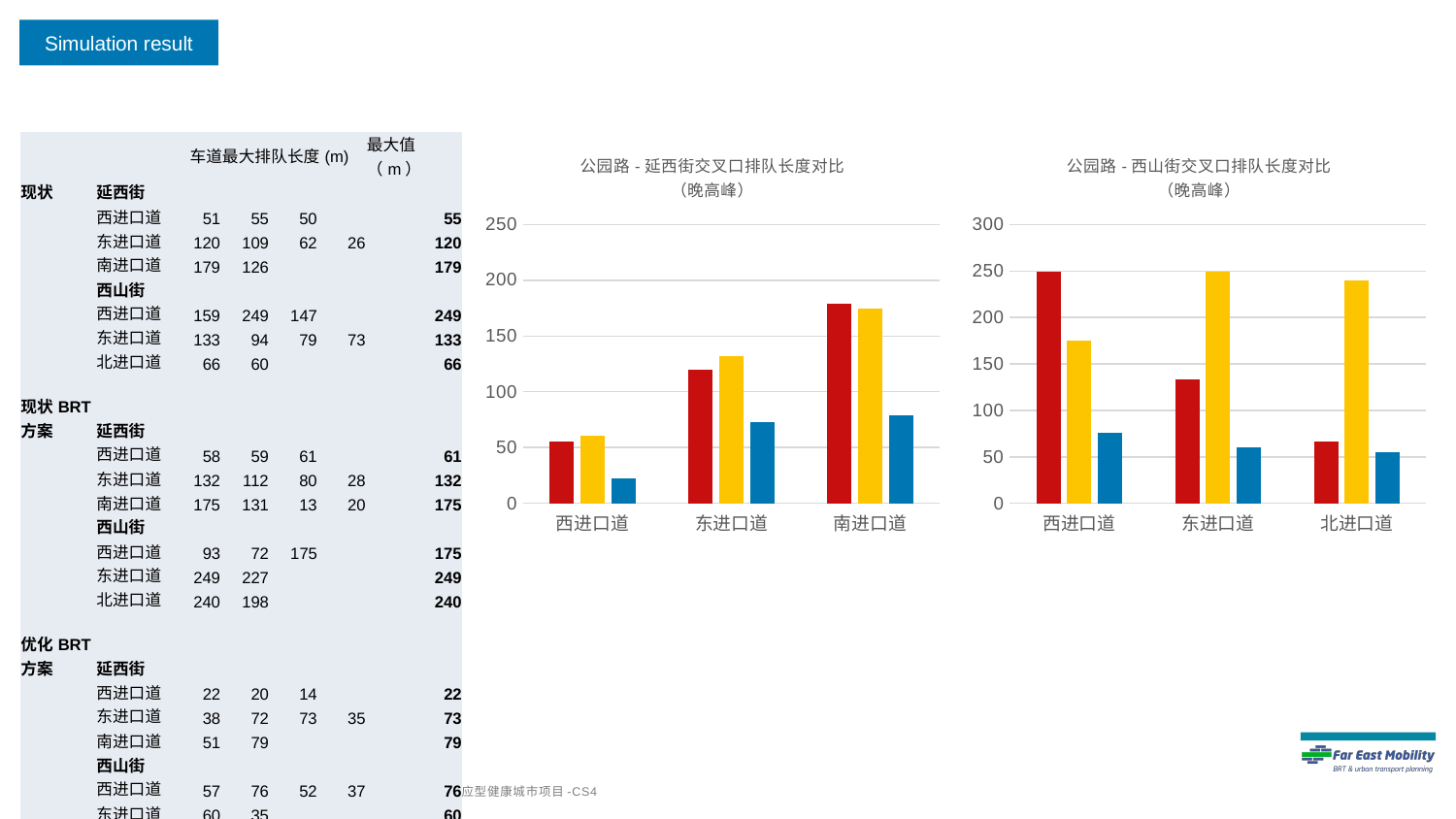
How many categories are shown on the x axis of the left chart (公园路 - 延西街交叉口排队长度对比)? 3 In the left chart (公园路 - 延西街交叉口排队长度对比), which category has the tallest red bar? 南进口道 In the left chart (公园路 - 延西街交叉口排队长度对比), is the red bar for 南进口道 greater or less than 150? greater In the right chart (公园路 - 西山街交叉口排队长度对比), which category has the shortest yellow bar? 西进口道 In the left chart (公园路 - 延西街交叉口排队长度对比), which category has the shortest blue bar? 西进口道 In the left chart (公园路 - 延西街交叉口排队长度对比), do the red bars rise or fall from 西进口道 to 南进口道? rise In the left chart (公园路 - 延西街交叉口排队长度对比), is the blue bar for 西进口道 greater or less than 50? less In the right chart (公园路 - 西山街交叉口排队长度对比), is the yellow bar for 东进口道 greater or less than 200? greater What is the highest value shown on the y axis of the right chart (公园路 - 西山街交叉口排队长度对比)? 300 In the right chart (公园路 - 西山街交叉口排队长度对比), for 西进口道, which is taller: the red bar or the yellow bar? the red bar In the right chart (公园路 - 西山街交叉口排队长度对比), which category has the tallest red bar? 西进口道 What kind of chart is the left chart titled 公园路 - 延西街交叉口排队长度对比（晚高峰）? bar chart